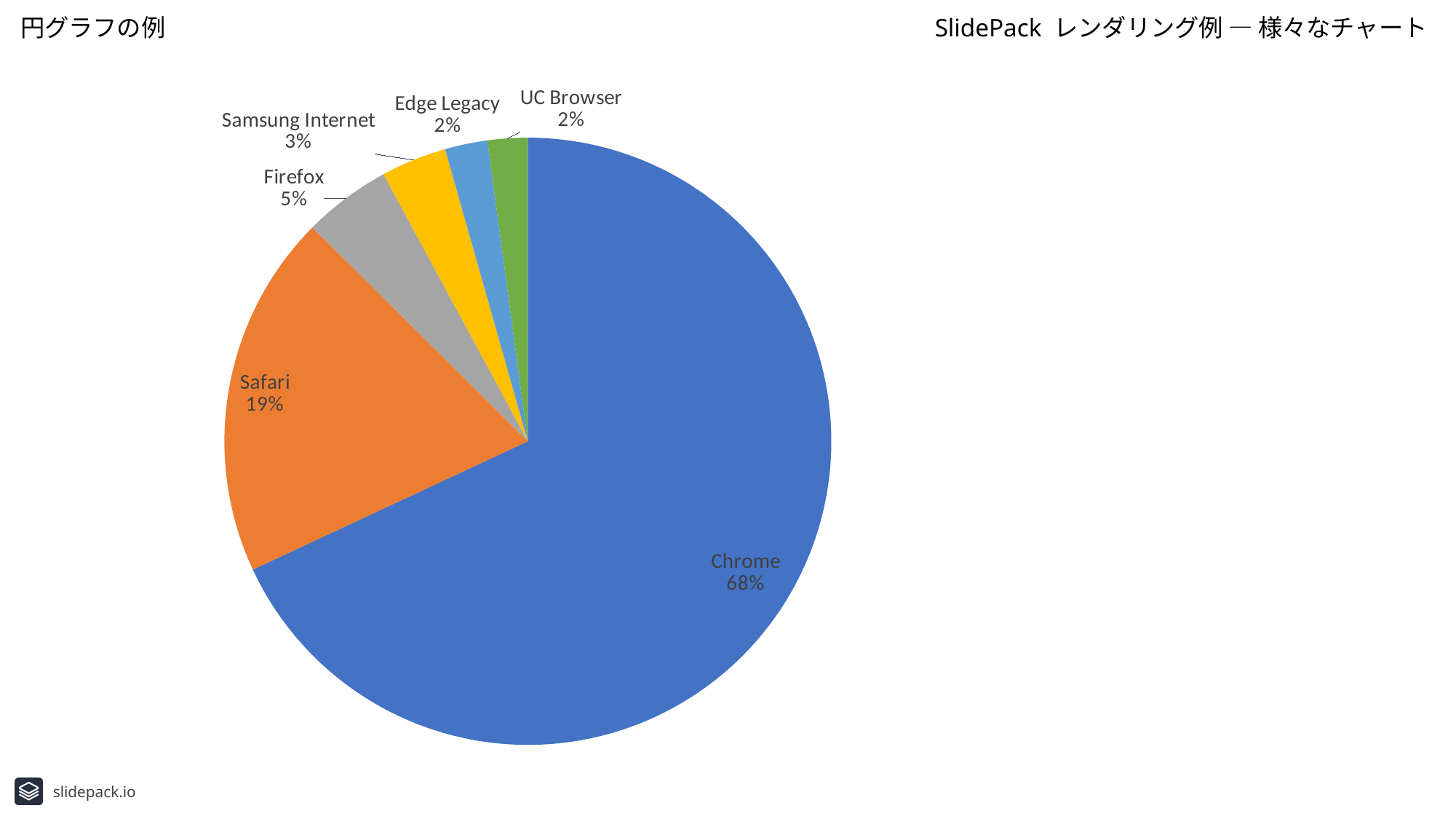
Which browser has the largest slice of the pie? Chrome What is the difference in percentage points between Chrome and Safari? 49 What kind of chart is shown on the slide? pie chart How many slices does the pie chart have? 6 What share of the pie does Safari have? 19% What share of the pie does Chrome have? 68% What share of the pie does Edge Legacy have? 2% What is the difference in percentage points between Safari and Firefox? 14 What share of the pie does Samsung Internet have? 3% What colour is the Safari slice? orange What share of the pie does Firefox have? 5% Which slice is larger, Firefox or Samsung Internet? Firefox